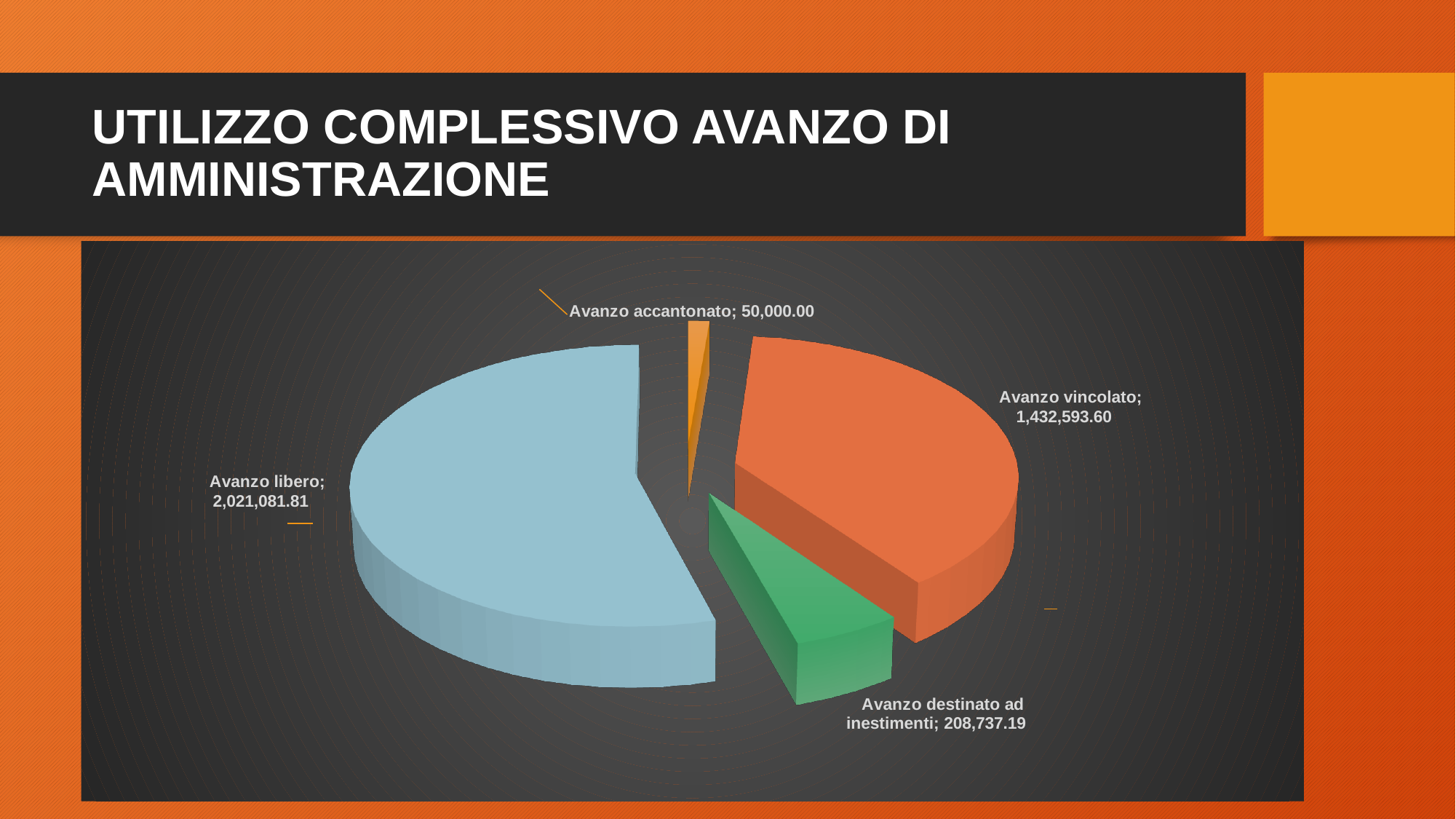
Which category has the largest slice of the pie? Avanzo libero What is the value for Avanzo destinato ad inestimenti? 208,737.19 What is the title of the slide containing the pie chart? UTILIZZO COMPLESSIVO AVANZO DI AMMINISTRAZIONE What is the value for Avanzo libero? 2,021,081.81 What is the value for Avanzo accantonato? 50,000.00 What kind of chart is shown on the slide? Pie chart How many slices does the pie chart have? 4 What is the difference between the values for Avanzo destinato ad inestimenti and Avanzo accantonato? 158,737.19 Which category has the smallest slice of the pie? Avanzo accantonato What is the value for Avanzo vincolato? 1,432,593.60 Which is larger, the value for Avanzo vincolato or the value for Avanzo destinato ad inestimenti? Avanzo vincolato What is the difference between the values for Avanzo libero and Avanzo vincolato? 588,488.21